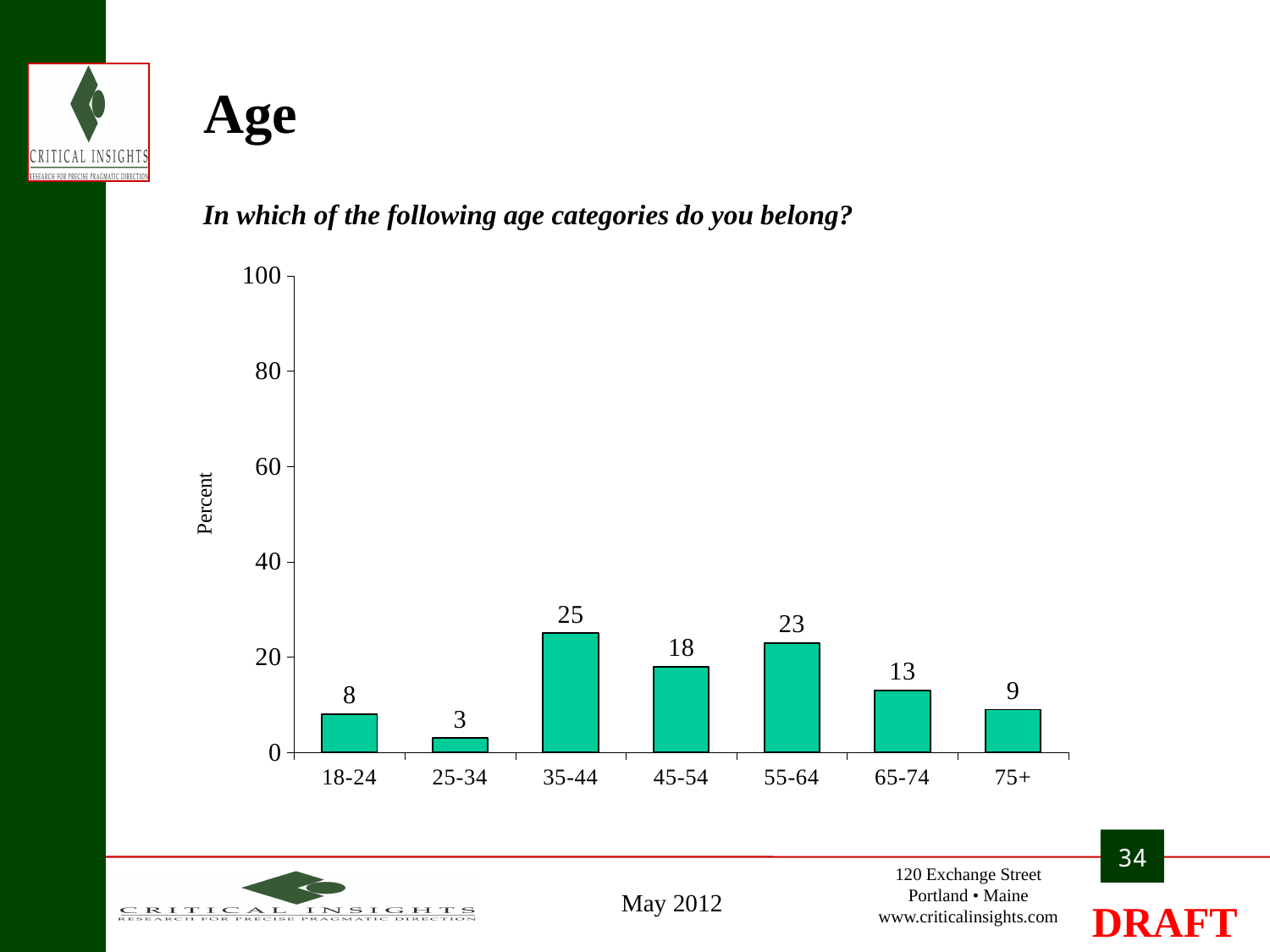
What kind of chart is shown on the slide? bar chart What is the label on the vertical axis? Percent What is the difference between the values for 18-24 and 25-34? 5 Which is larger, the value for 45-54 or the value for 55-64? 55-64 What percent of respondents are aged 75+? 9 Which age category has the highest percentage? 35-44 Which age category has the lowest percentage? 25-34 Is the value for 35-44 greater or less than 20? greater How many age categories are shown on the x axis? 7 What is the difference between the values for 55-64 and 65-74? 10 What percent of respondents are in the 35-44 age category? 25 What is the value shown for the 25-34 age category? 3